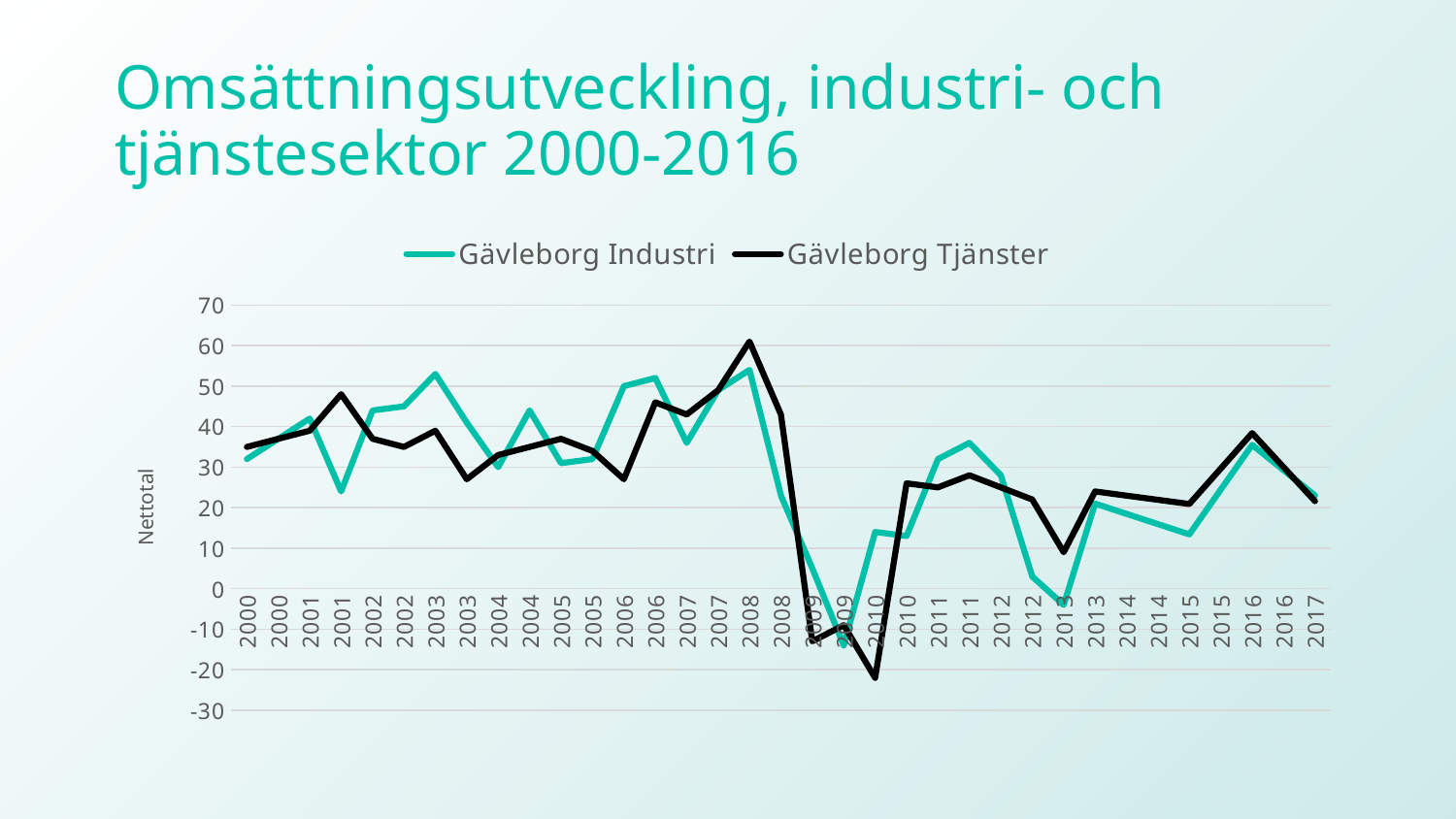
How many series does the legend list? 2 Is the value for Gävleborg Industri at the first 2013 point greater or less than 10? less At the second 2001 point, which series has the larger value, Gävleborg Industri or Gävleborg Tjänster? Gävleborg Tjänster Do both series rise or fall between 2008 and 2009? fall At the first 2003 point, which series has the larger value, Gävleborg Industri or Gävleborg Tjänster? Gävleborg Industri Is the lowest value of Gävleborg Tjänster around 2010 greater or less than -10? less What kind of chart is shown on the slide? Line chart What are the two series named in the legend? Gävleborg Industri and Gävleborg Tjänster What is the label on the vertical axis? Nettotal Is the peak value of Gävleborg Tjänster in 2008 greater or less than 50? greater Which series reaches the highest value on the chart? Gävleborg Tjänster Which series reaches the lowest value on the chart? Gävleborg Tjänster